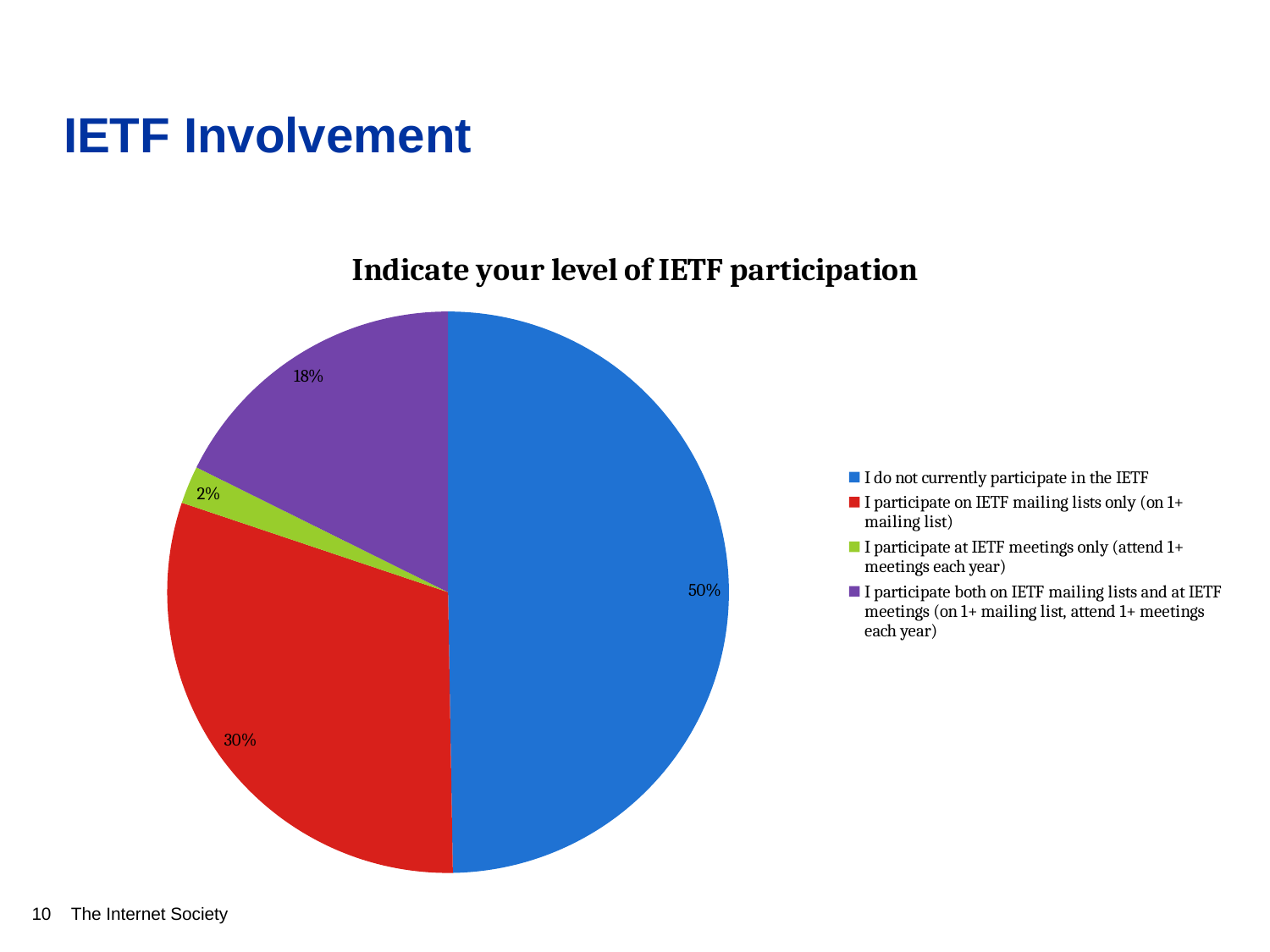
What share of respondents participate at IETF meetings only? 2% What colour is the slice for "I participate at IETF meetings only"? Green What share of respondents participate both on IETF mailing lists and at IETF meetings? 18% How many slices does the pie chart have? 4 What share of respondents said "I do not currently participate in the IETF"? 50% Which is larger: the share participating on mailing lists only or the share participating both on mailing lists and at meetings? Mailing lists only Which response has the largest share of the pie? I do not currently participate in the IETF What is the title of the chart? Indicate your level of IETF participation What is the difference in percentage points between those who do not currently participate and those who participate on mailing lists only? 20 percentage points Which response has the smallest share of the pie? I participate at IETF meetings only (attend 1+ meetings each year) What type of chart is shown on the slide? Pie chart